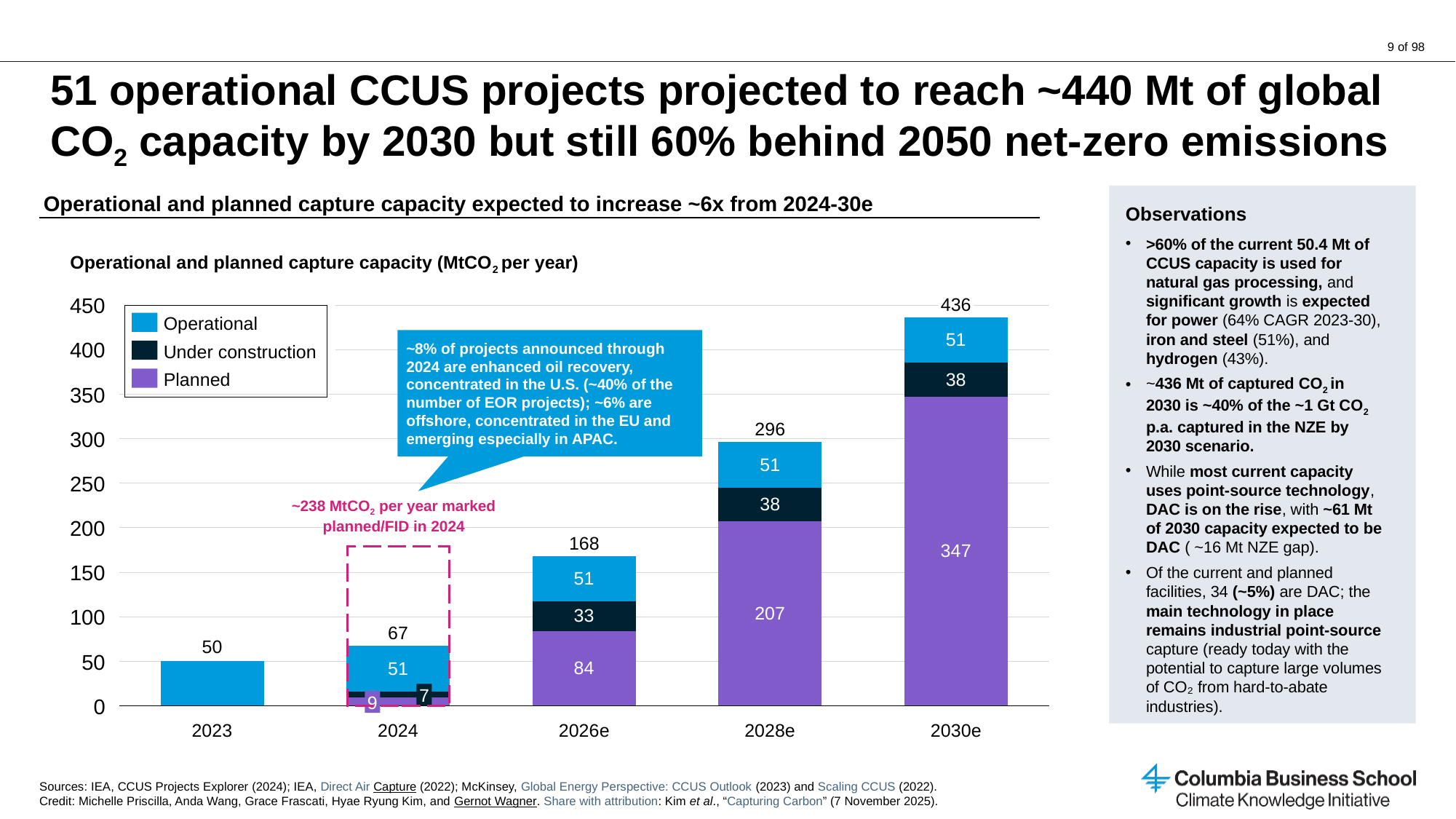
Do the total capture capacity values rise or fall from 2023 to 2030e? Rise Which is larger, the Planned value for 2028e or the Planned value for 2026e? 2028e What is the Planned capture capacity for 2030e? 347 What is the total capture capacity shown for 2028e? 296 How many years are shown on the x axis of the chart? 5 What are the three series listed in the chart's legend? Operational, Under construction, Planned Which year has the highest total capture capacity? 2030e What is the Under construction value for 2026e? 33 What kind of chart is shown on the slide? Stacked bar chart What is the difference between the total capture capacity for 2030e and 2028e? 140 How many series does the chart's legend list? 3 Which year has the lowest total capture capacity? 2023